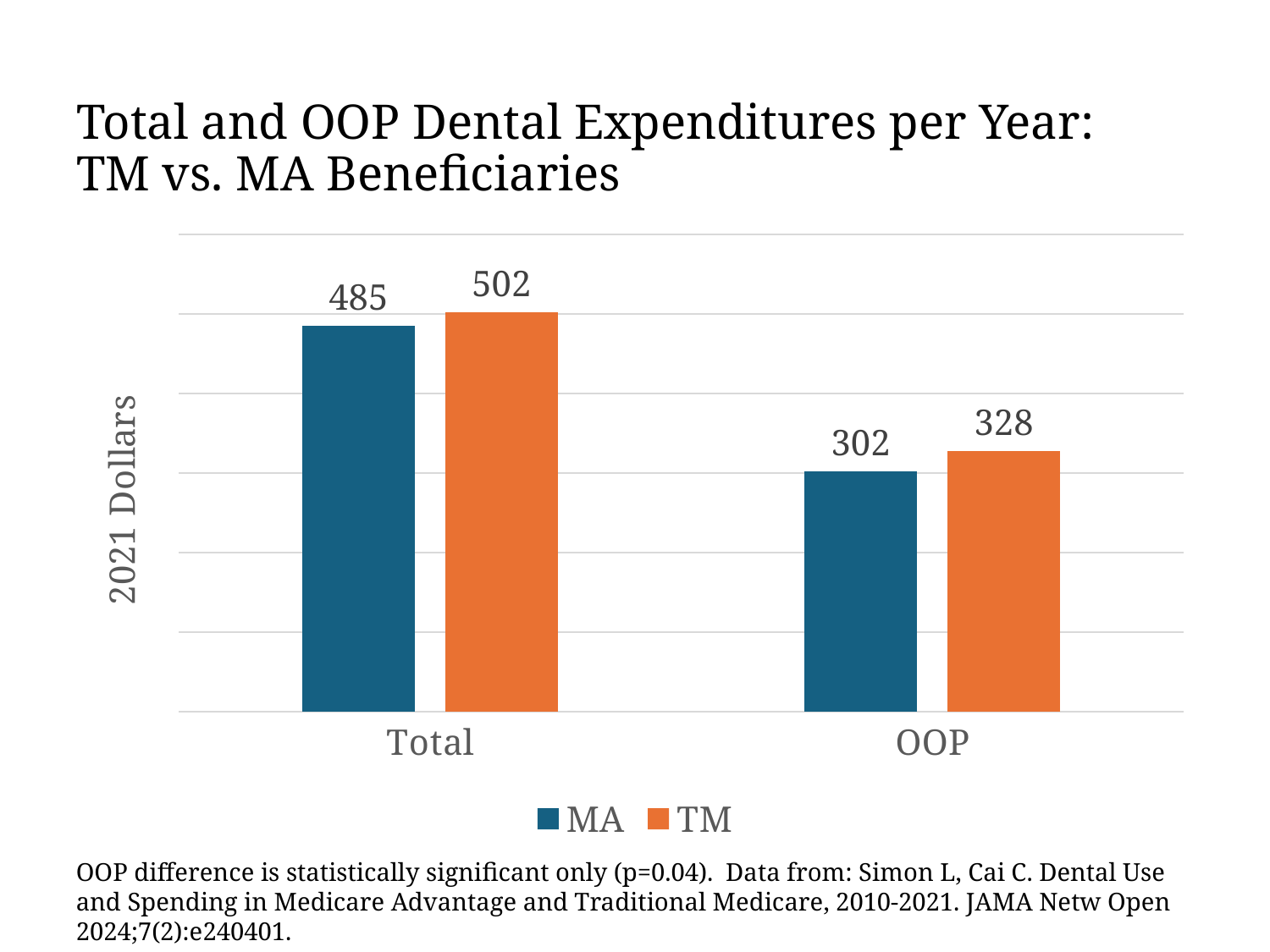
What is the value for TM in the Total category? 502 Which bar has the highest value on the chart? TM, Total (502) What is the value for MA in the Total category? 485 What is the value for MA in the OOP category? 302 How many series does the legend list? 2 What is the difference between the TM and MA values in the Total category? 17 What is the value for TM in the OOP category? 328 Which series has the lower value in the OOP category, MA or TM? MA How many categories are shown on the x axis? 2 What is the difference between the TM and MA values in the OOP category? 26 What type of chart is shown on the slide? Bar chart Which series has the higher value in the Total category, MA or TM? TM